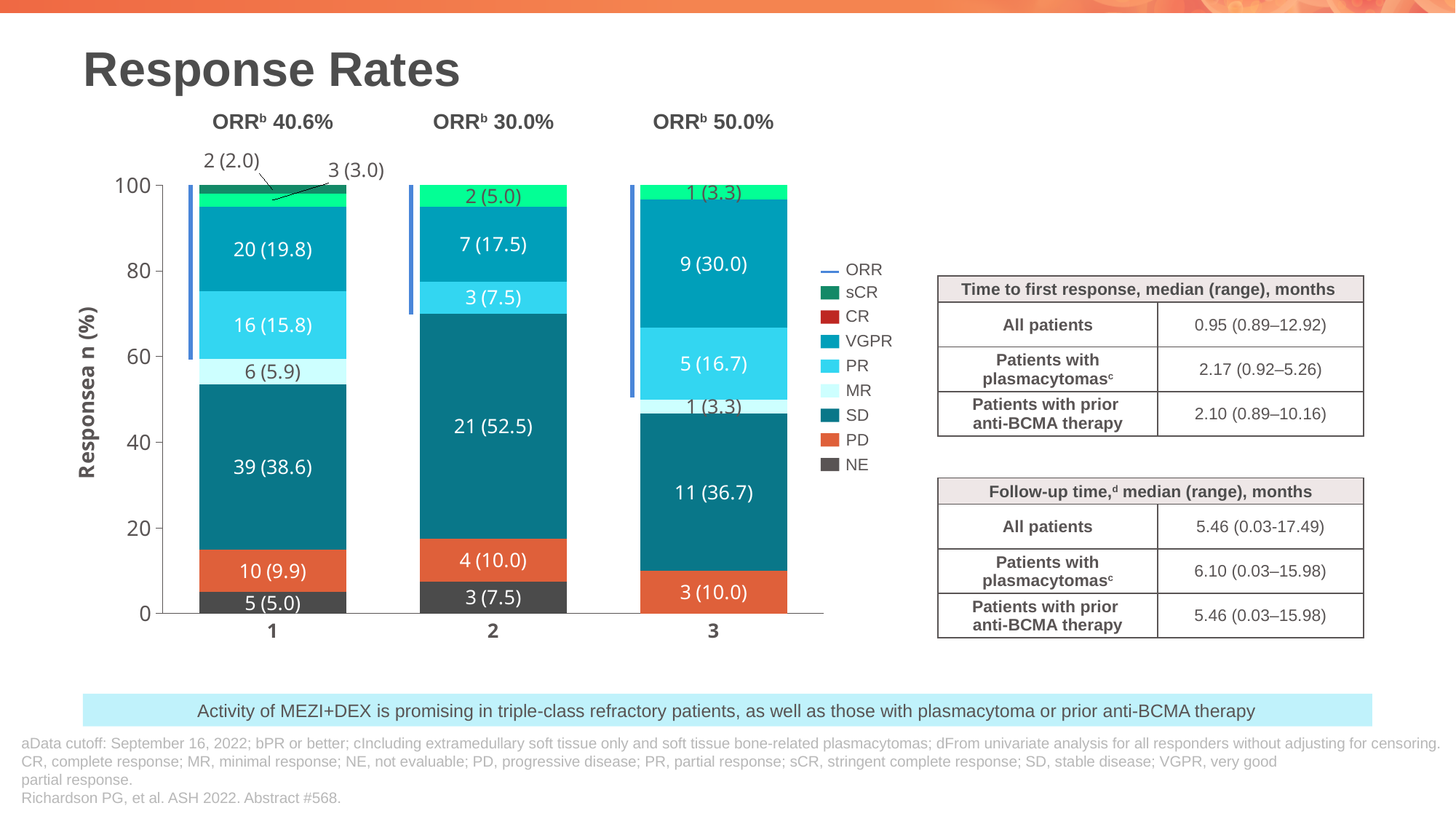
How many bars are plotted on the chart? 3 What is the y-axis title of the chart? Responsea n (%) Which bar has the larger SD percentage, bar 1 or bar 2? Bar 2 How many entries does the chart legend list? 9 Which bar has the highest ORR? 3 What is the data label for the VGPR segment of bar 3? 9 (30.0) What kind of chart is shown on the slide? Stacked bar chart What is the ORR shown above bar 2? 30.0% Which bar has the lowest ORR? 2 What is the data label for the PD segment of bar 2? 4 (10.0) What is the difference in VGPR patient counts between bar 1 and bar 2? 13 What is the data label for the SD segment of bar 1? 39 (38.6)